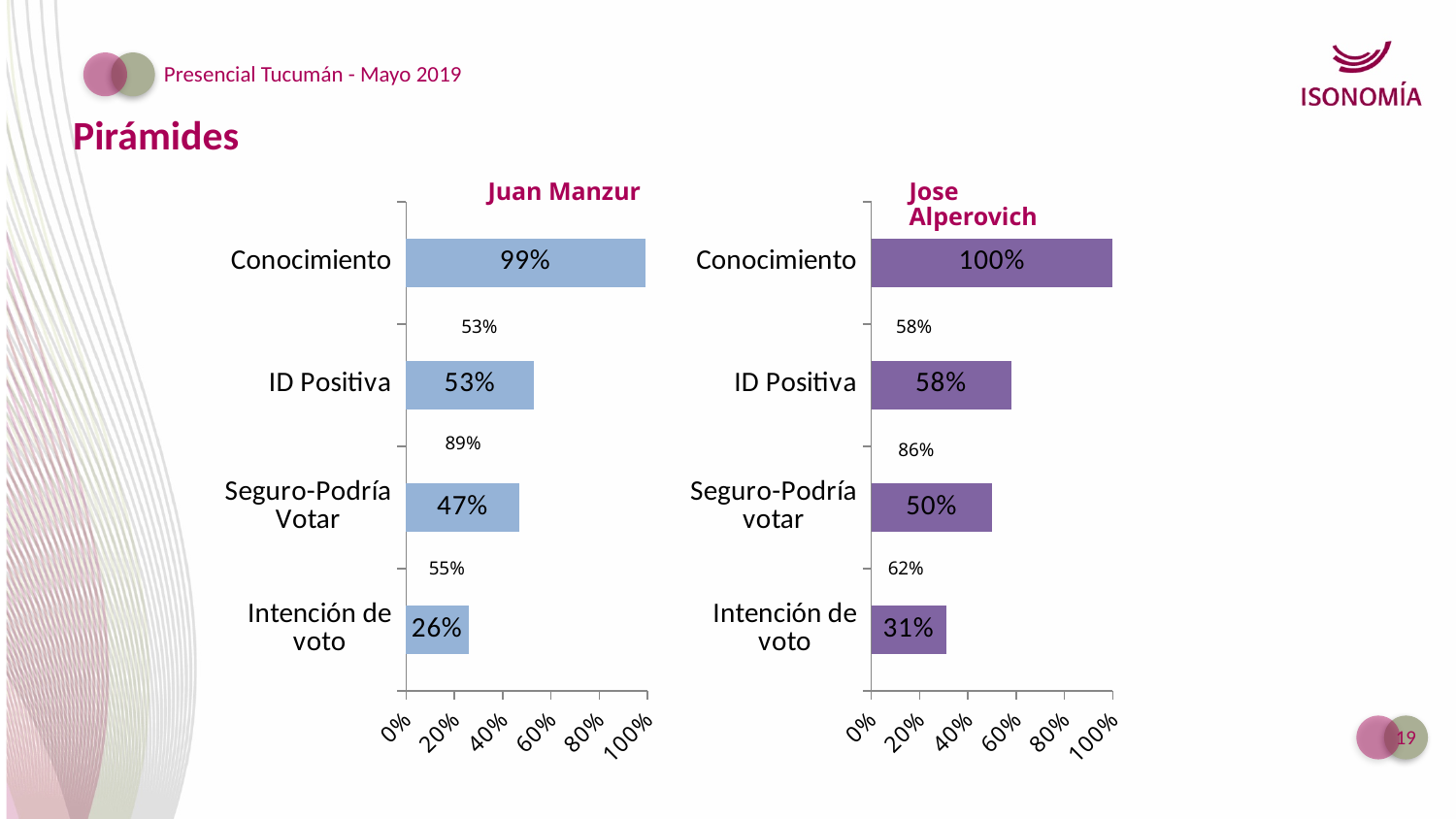
How many categories are shown in the Juan Manzur chart? 4 In the Jose Alperovich chart, what is the value for ID Positiva? 58% What kind of chart is the Jose Alperovich chart? Bar chart In the Jose Alperovich chart, what is the difference between Seguro-Podría votar and Intención de voto? 19 percentage points In the Juan Manzur chart, what is the value for Seguro-Podría Votar? 47% In the Juan Manzur chart, what is the value for Conocimiento? 99% In the Jose Alperovich chart, which category has the highest value? Conocimiento In the Jose Alperovich chart, what is the value for Intención de voto? 31% What is the title of the slide? Pirámides Which is larger: Intención de voto for Juan Manzur or Intención de voto for Jose Alperovich? Jose Alperovich In the Juan Manzur chart, which category has the lowest value? Intención de voto In the Juan Manzur chart, what is the difference between Conocimiento and ID Positiva? 46 percentage points